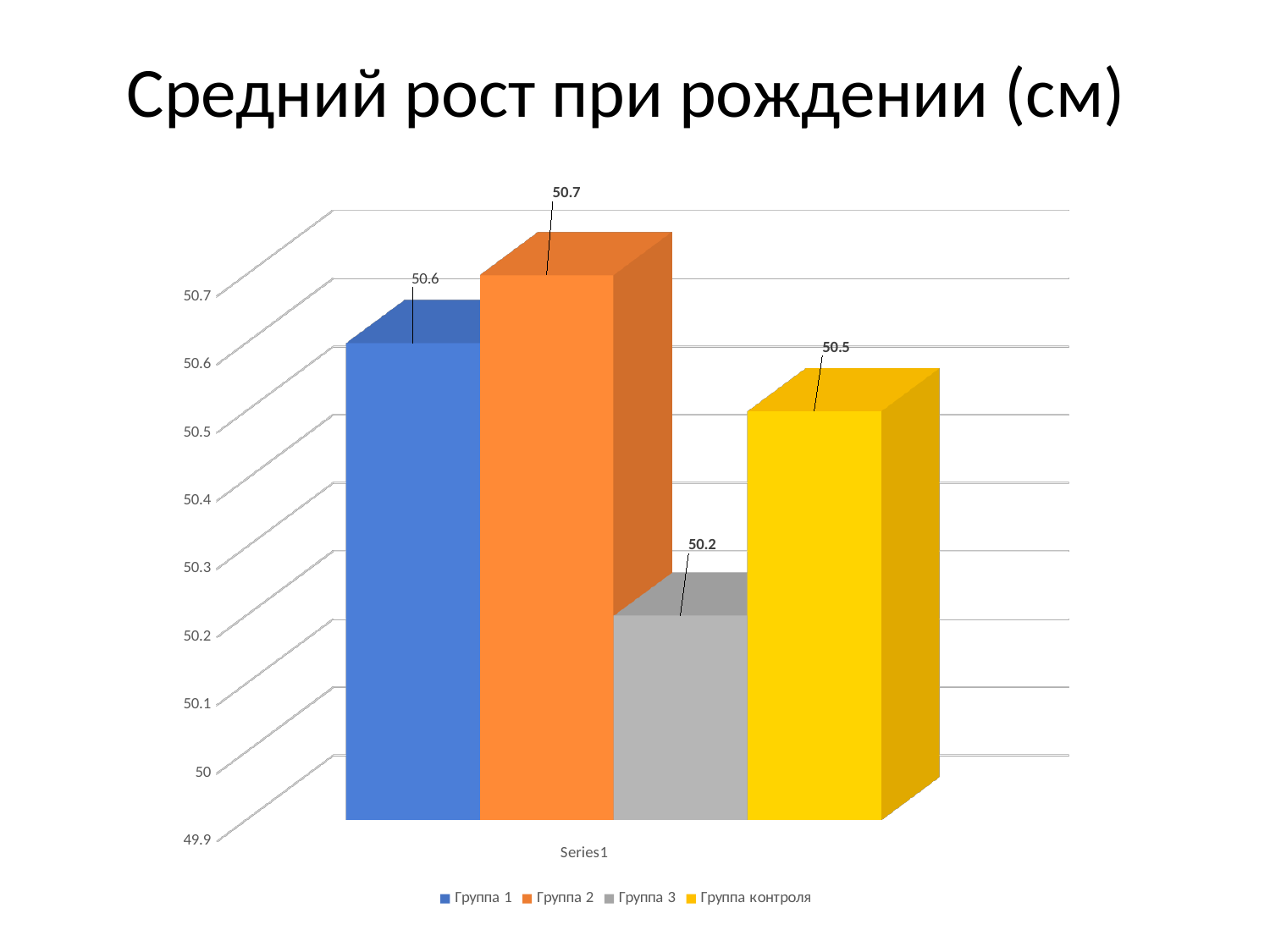
What is the value for Группа 2? 50.7 What is the value for Группа 3? 50.2 What is the title of the slide? Средний рост при рождении (см) Which group has the highest value? Группа 2 What is the value for Группа контроля? 50.5 Is the value for Группа 3 greater or less than 50.4? less Which is larger, the value for Группа 1 or the value for Группа контроля? Группа 1 Which group has the lowest value? Группа 3 What is the difference between the values for Группа 2 and Группа 3? 0.5 What is the value for Группа 1? 50.6 What kind of chart is shown on the slide? bar chart How many series does the legend list? 4